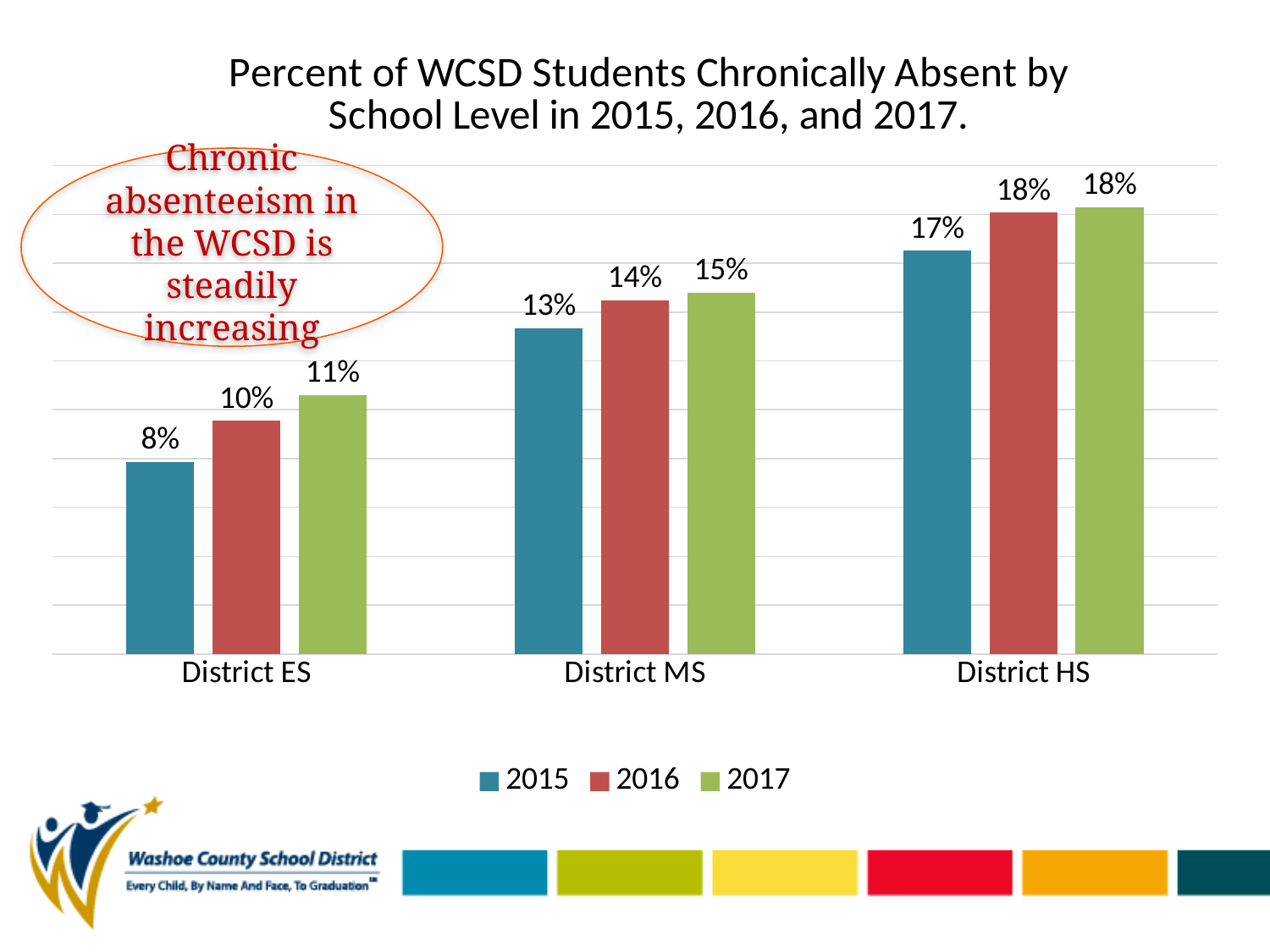
What is the difference between the 2017 and 2015 values for District ES? 3% What kind of chart is shown on the slide? Bar chart How many series does the legend list? 3 What percent of District HS students were chronically absent in 2017? 18% Which school level had the lowest percent of chronically absent students in 2015? District ES How many school levels are shown on the x axis? 3 What percent of District MS students were chronically absent in 2016? 14% Do the values for District MS rise or fall from 2015 to 2017? Rise Which is larger, the 2017 value for District MS or the 2015 value for District HS? 2015 value for District HS What percent of District ES students were chronically absent in 2015? 8% Which school level had the highest percent of chronically absent students in 2017? District HS What is the difference between the District HS and District MS values in 2016? 4%